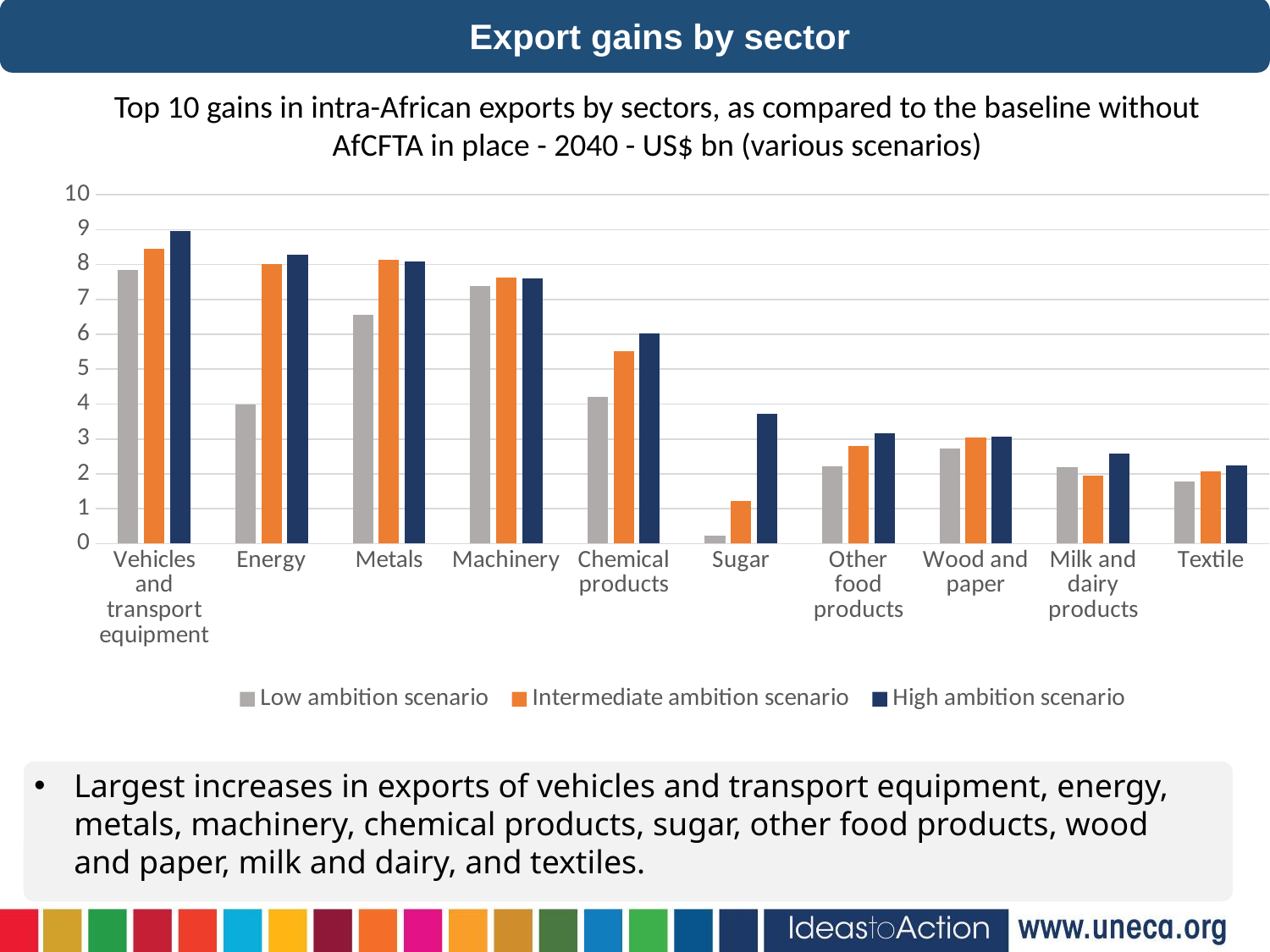
Which colour represents the High ambition scenario in the legend? Dark blue Is the Low ambition scenario value for Textile greater or less than 3? less Which sector has the highest value in the High ambition scenario? Vehicles and transport equipment How many sectors are shown on the x axis? 10 For Energy, which is larger: the Low ambition scenario or the Intermediate ambition scenario? Intermediate ambition scenario Which sector has the lowest value in the Low ambition scenario? Sugar Is the High ambition scenario value for Sugar greater or less than 3? greater In the High ambition scenario, which is larger: Chemical products or Sugar? Chemical products Is the Low ambition scenario value for Energy greater or less than 5? less What kind of chart is shown on the slide? Bar chart How many series does the legend list? 3